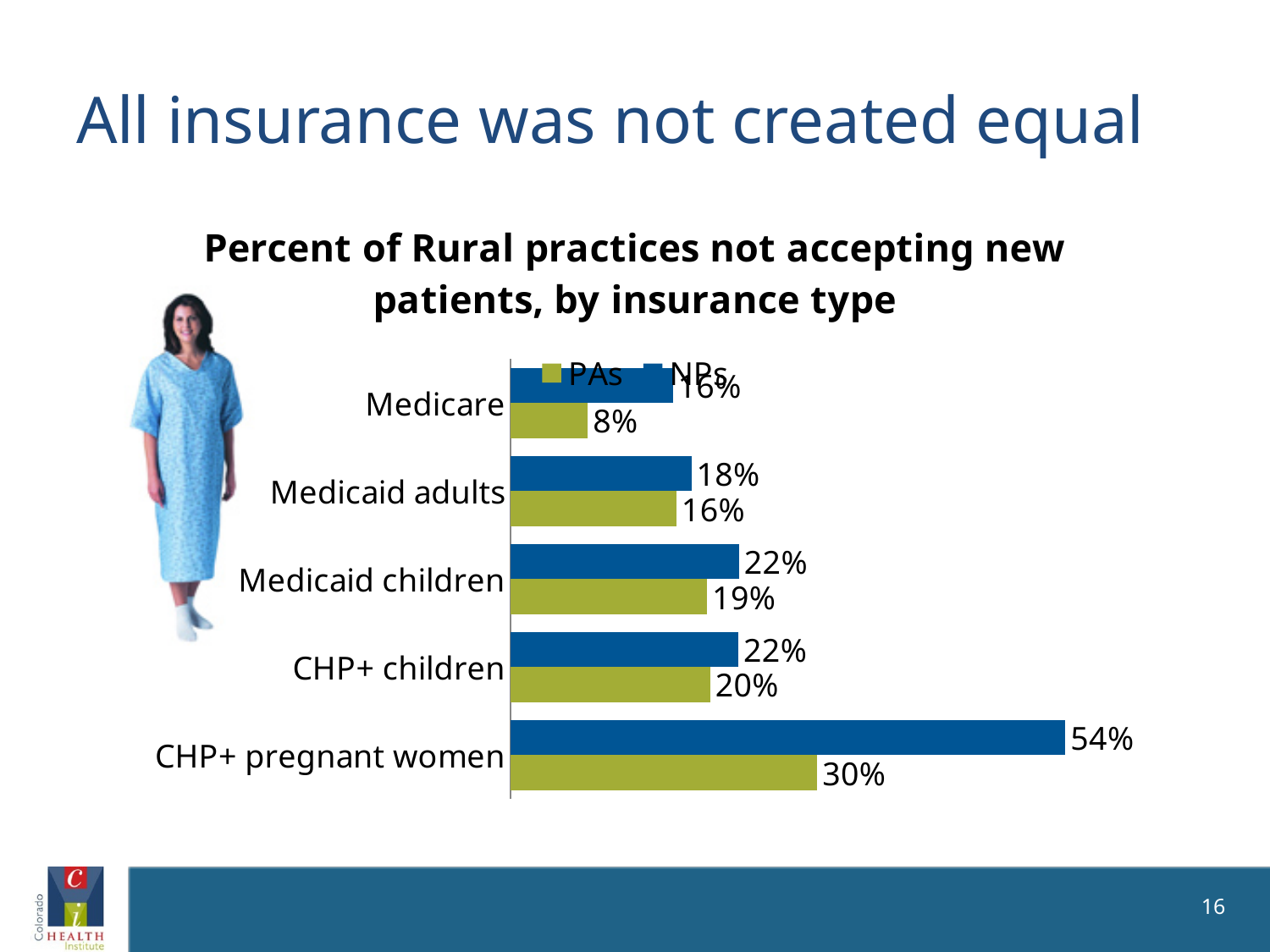
Which insurance type has the lowest PAs value? Medicare What is the PAs value for Medicaid children? 19% What kind of chart is shown on the slide? Bar chart Which insurance type has the highest NPs value? CHP+ pregnant women What is the difference between the NPs and PAs values for CHP+ pregnant women? 24% What is the PAs value for CHP+ pregnant women? 30% What is the NPs value for Medicaid adults? 18% How many insurance types are shown on the chart? 5 For CHP+ children, which is larger, the NPs value or the PAs value? NPs How many series does the legend list? 2 What is the PAs value for Medicare? 8% What percent of rural practices are not accepting new CHP+ pregnant women patients according to NPs? 54%